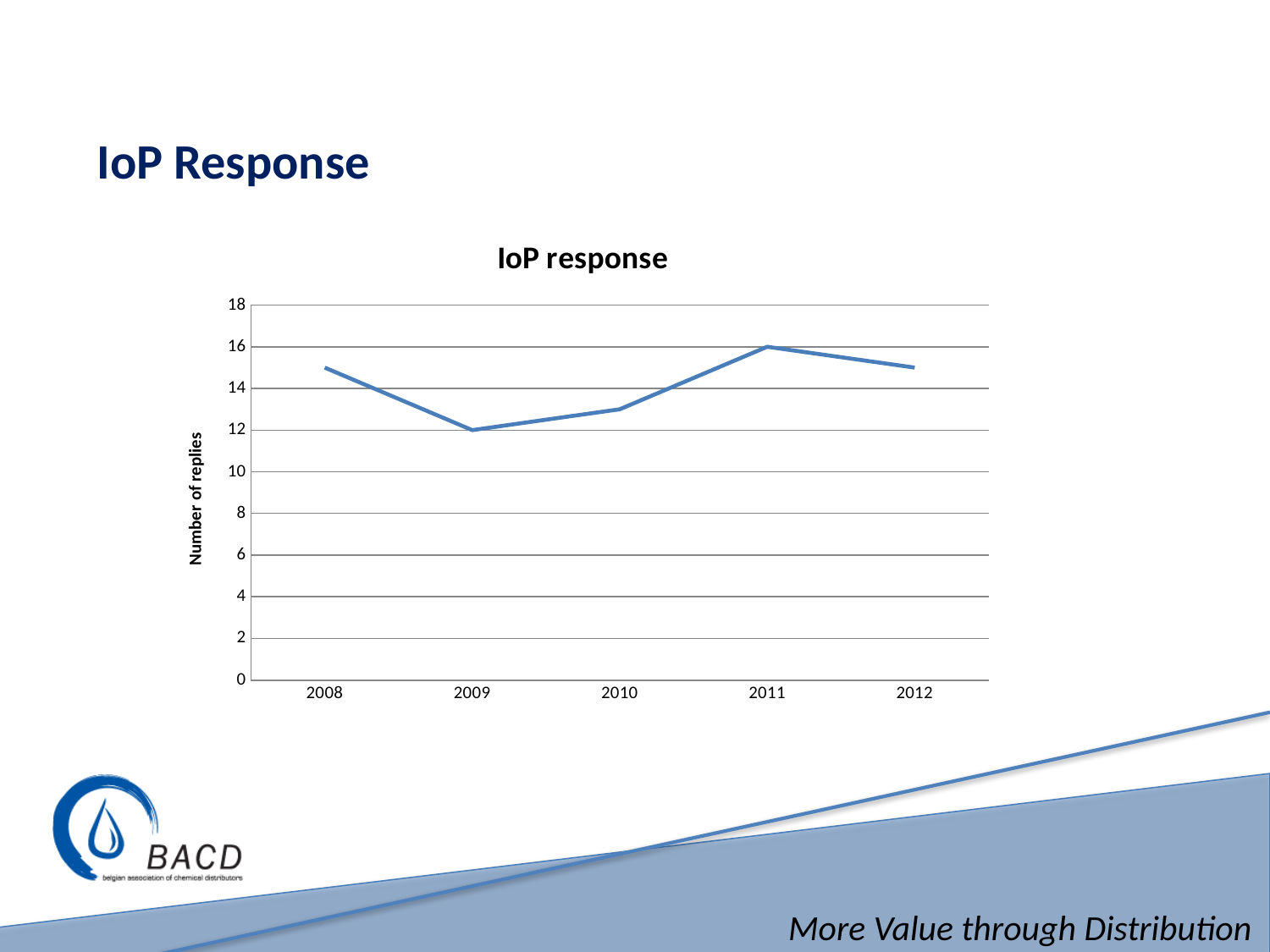
What kind of chart is shown on the slide? line chart Is the value for 2008 greater or less than 14? greater Which year has the lowest number of replies? 2009 Which year has more replies, 2010 or 2011? 2011 What is the difference in number of replies between 2011 and 2009? 4 What is the label of the vertical axis? Number of replies What is the number of replies in 2011? 16 Is the value for 2010 greater or less than 14? less Which year has the highest number of replies? 2011 What is the title of the chart? IoP response What is the number of replies in 2009? 12 How many years are plotted on the x axis? 5